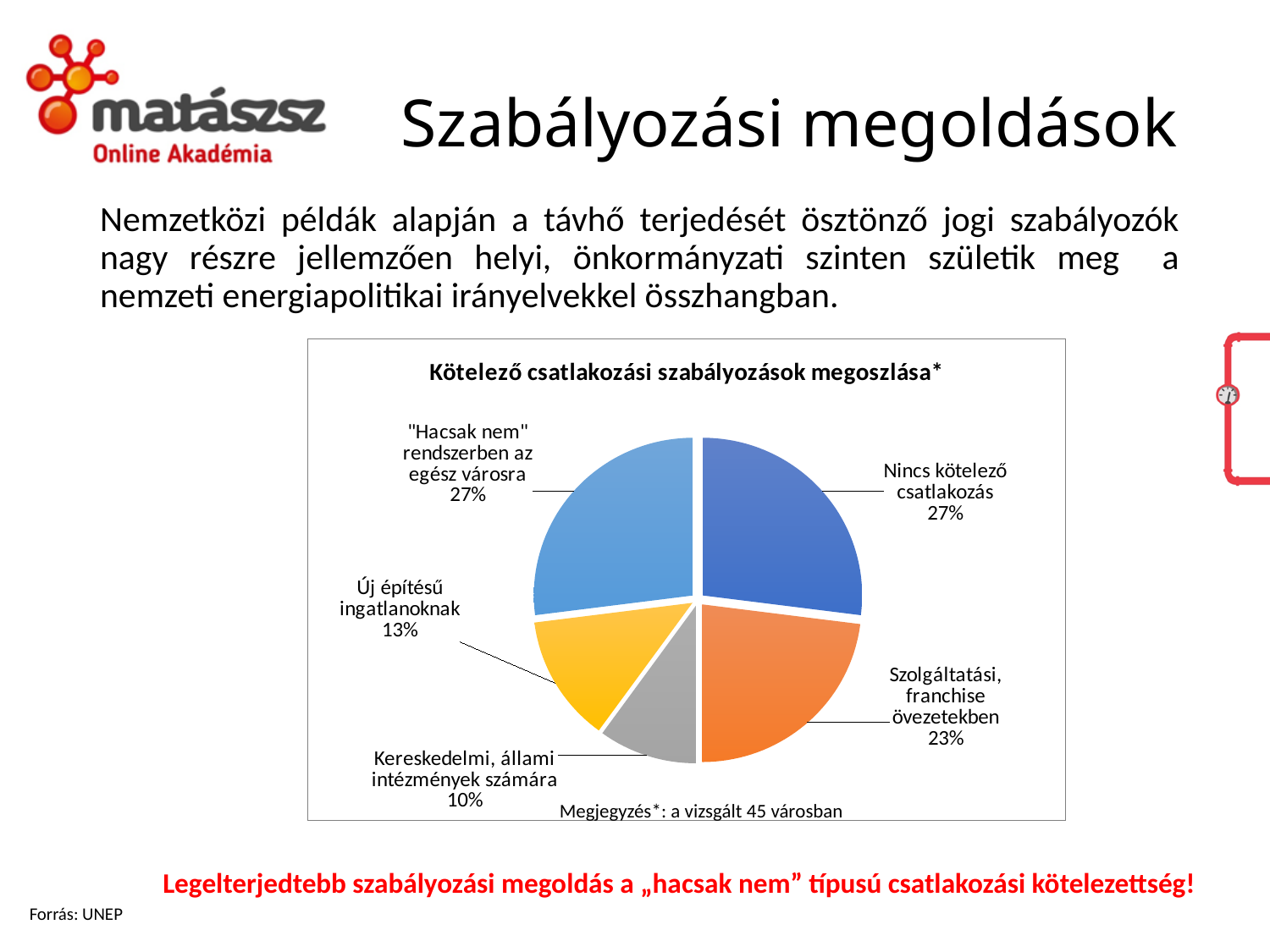
According to the note below the chart, how many cities were examined? 45 Which category has the smallest share of the pie? Kereskedelmi, állami intézmények számára How many slices does the pie chart have? 5 What kind of chart is shown on the slide? pie chart What share of the pie is ""Hacsak nem" rendszerben az egész városra"? 27% What share of the pie is "Nincs kötelező csatlakozás"? 27% What share of the pie is "Szolgáltatási, franchise övezetekben"? 23% Which is larger: the share for "Szolgáltatási, franchise övezetekben" or for "Új építésű ingatlanoknak"? Szolgáltatási, franchise övezetekben What is the title of the chart? Kötelező csatlakozási szabályozások megoszlása* What is the difference in percentage points between "Nincs kötelező csatlakozás" and "Kereskedelmi, állami intézmények számára"? 17